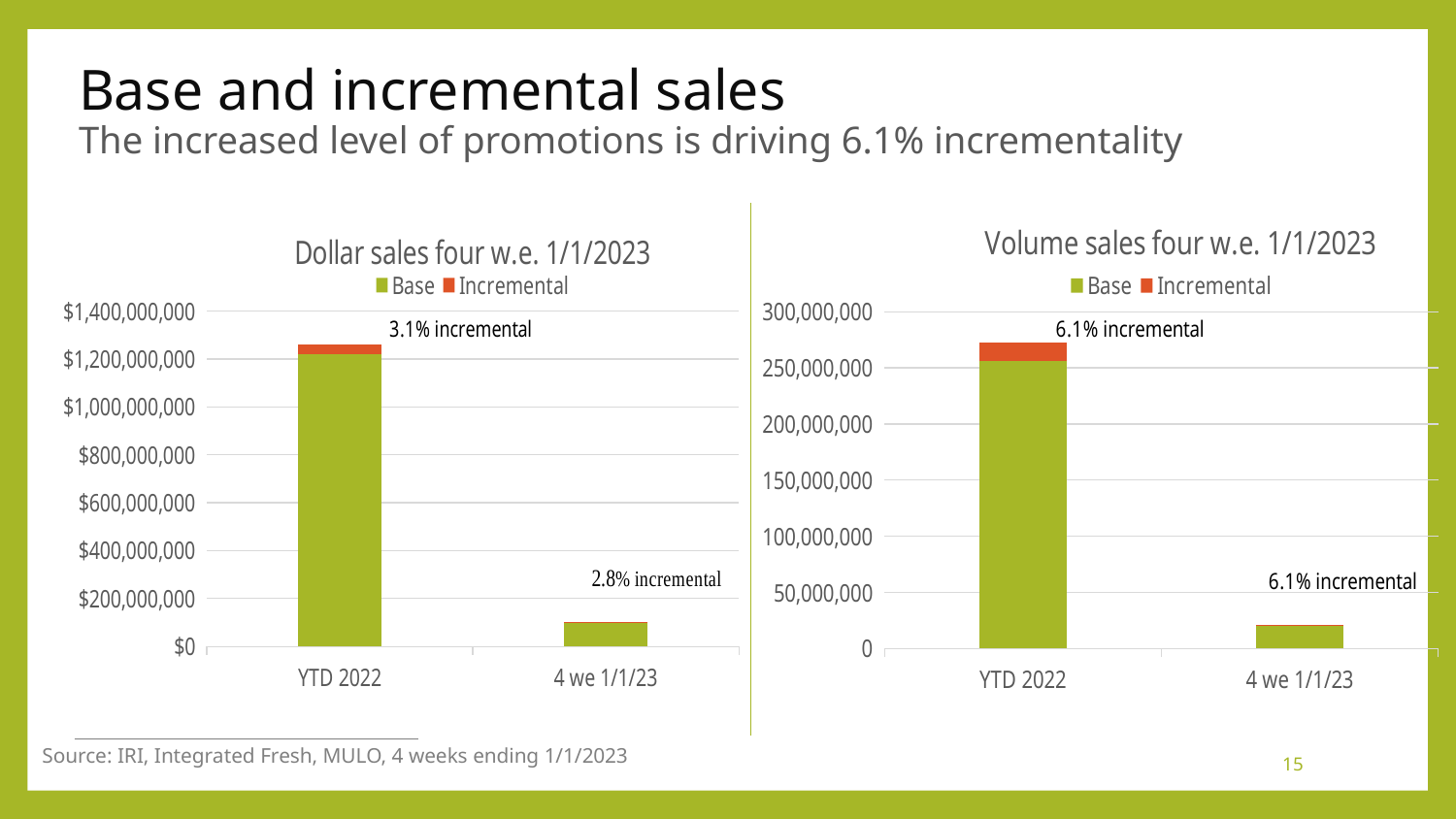
In the Volume sales four w.e. 1/1/2023 chart, is the total value for 4 we 1/1/23 greater or less than 50,000,000? less In the Dollar sales four w.e. 1/1/2023 chart, which is larger, the bar for YTD 2022 or the bar for 4 we 1/1/23? YTD 2022 In the Dollar sales four w.e. 1/1/2023 chart, what incremental percentage is labelled for YTD 2022? 3.1% In the Dollar sales four w.e. 1/1/2023 chart, what incremental percentage is labelled for 4 we 1/1/23? 2.8% In the Dollar sales four w.e. 1/1/2023 chart, is the total value for YTD 2022 greater or less than $1,000,000,000? greater What kind of chart is the Volume sales four w.e. 1/1/2023 chart? Stacked bar chart In the Volume sales four w.e. 1/1/2023 chart, what incremental percentage is labelled for 4 we 1/1/23? 6.1% In the Volume sales four w.e. 1/1/2023 chart, which category has the highest total? YTD 2022 In the Dollar sales four w.e. 1/1/2023 chart, is the total value for 4 we 1/1/23 greater or less than $200,000,000? less In the Volume sales four w.e. 1/1/2023 chart, what incremental percentage is labelled for YTD 2022? 6.1% How many series does the legend of the Dollar sales four w.e. 1/1/2023 chart list? 2